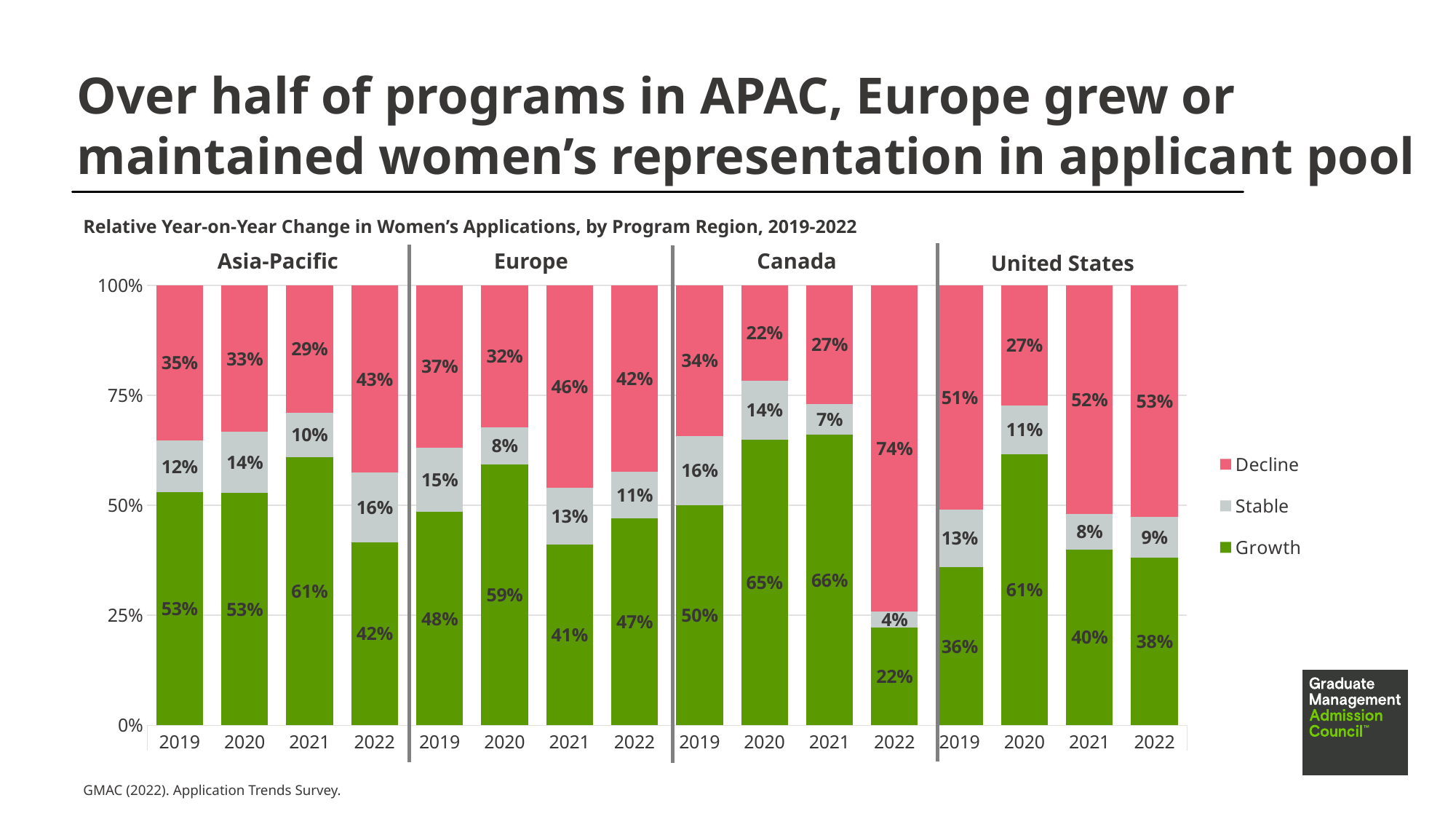
Does the Decline share for the United States rise or fall from 2020 to 2022? Rises How many bars are plotted in the chart? 16 Which had a larger Growth share in 2020: Europe or Canada? Canada (65% vs 59%) By how many percentage points did the Growth share in Asia-Pacific fall from 2021 to 2022? 19 percentage points What is the Decline share for the United States in 2019? 51% How many series does the legend list? 3 What is the Stable share for Europe in 2019? 15% Which region and year has the lowest Stable share? Canada 2022 (4%) Which region and year has the highest Decline share? Canada 2022 (74%) Which region and year has the highest Growth share? Canada 2021 (66%) What kind of chart is shown on the slide? Stacked bar chart What is the Growth share for Canada in 2022? 22%